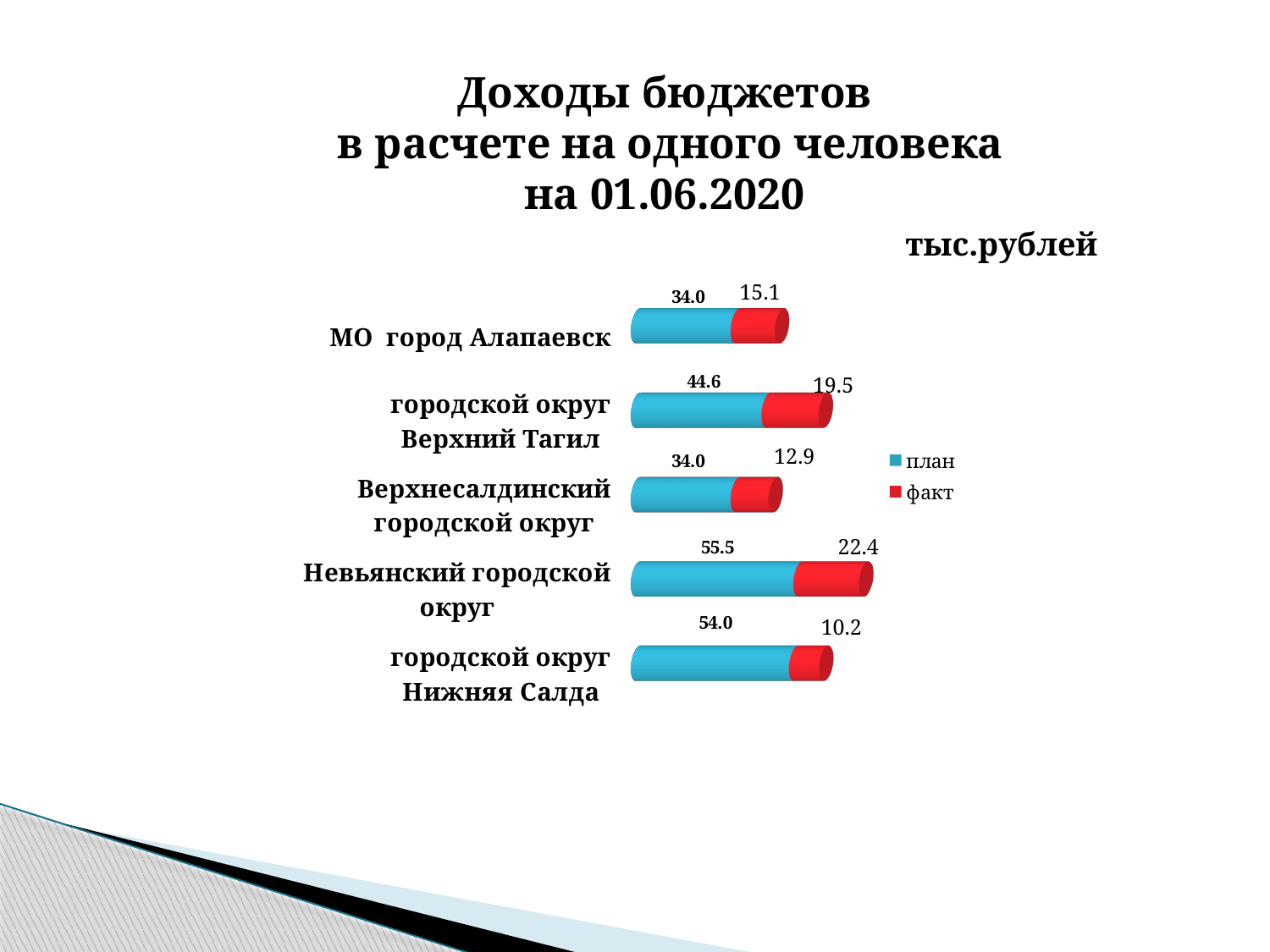
What is the план value for Невьянский городской округ? 55.5 How many categories are shown in the chart? 5 What kind of chart is shown on the slide? bar chart What is the difference between the план and факт values for Невьянский городской округ? 33.1 What is the факт value for городской округ Верхний Тагил? 19.5 Which category has the lowest факт value? городской округ Нижняя Салда What is the факт value for городской округ Нижняя Салда? 10.2 Which category has the highest план value? Невьянский городской округ What is the total of the stacked bar for Верхнесалдинский городской округ? 46.9 What is the difference between the план and факт values for городской округ Нижняя Салда? 43.8 How many series does the legend list? 2 Which is larger: the факт value for городской округ Верхний Тагил or the факт value for МО город Алапаевск? городской округ Верхний Тагил